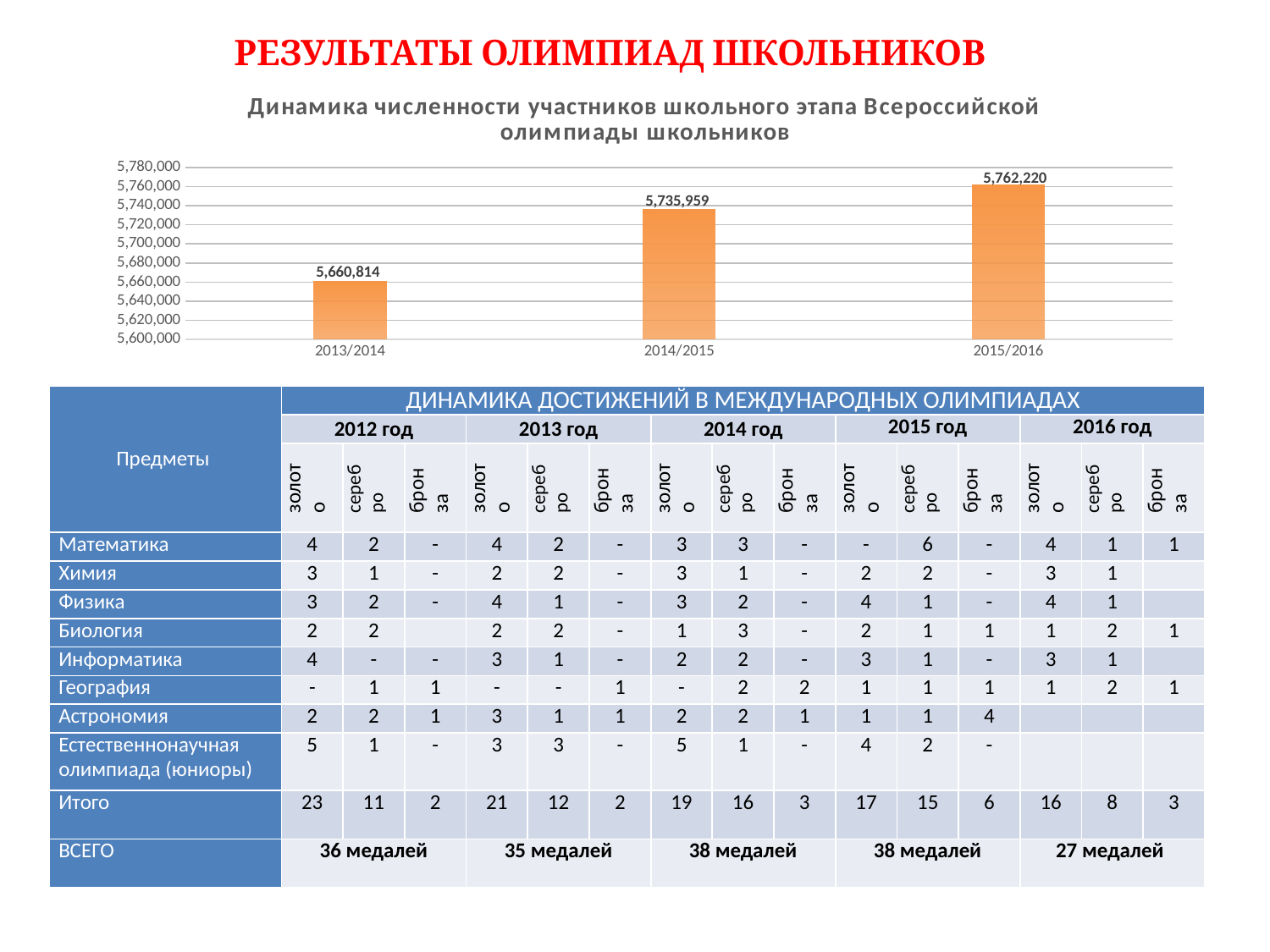
Do the values rise or fall from 2013/2014 to 2015/2016? rise What is the value for 2015/2016? 5,762,220 What is the difference between the values for 2015/2016 and 2014/2015? 26,261 How many academic years are shown on the chart? 3 Is the value for 2013/2014 greater or less than 5,700,000? less What is the value for 2013/2014? 5,660,814 What kind of chart is shown on the slide? bar chart Which is larger, the value for 2013/2014 or the value for 2015/2016? 2015/2016 Which academic year has the lowest number of participants? 2013/2014 What is the value for 2014/2015? 5,735,959 What is the difference between the values for 2014/2015 and 2013/2014? 75,145 Which academic year has the highest number of participants? 2015/2016